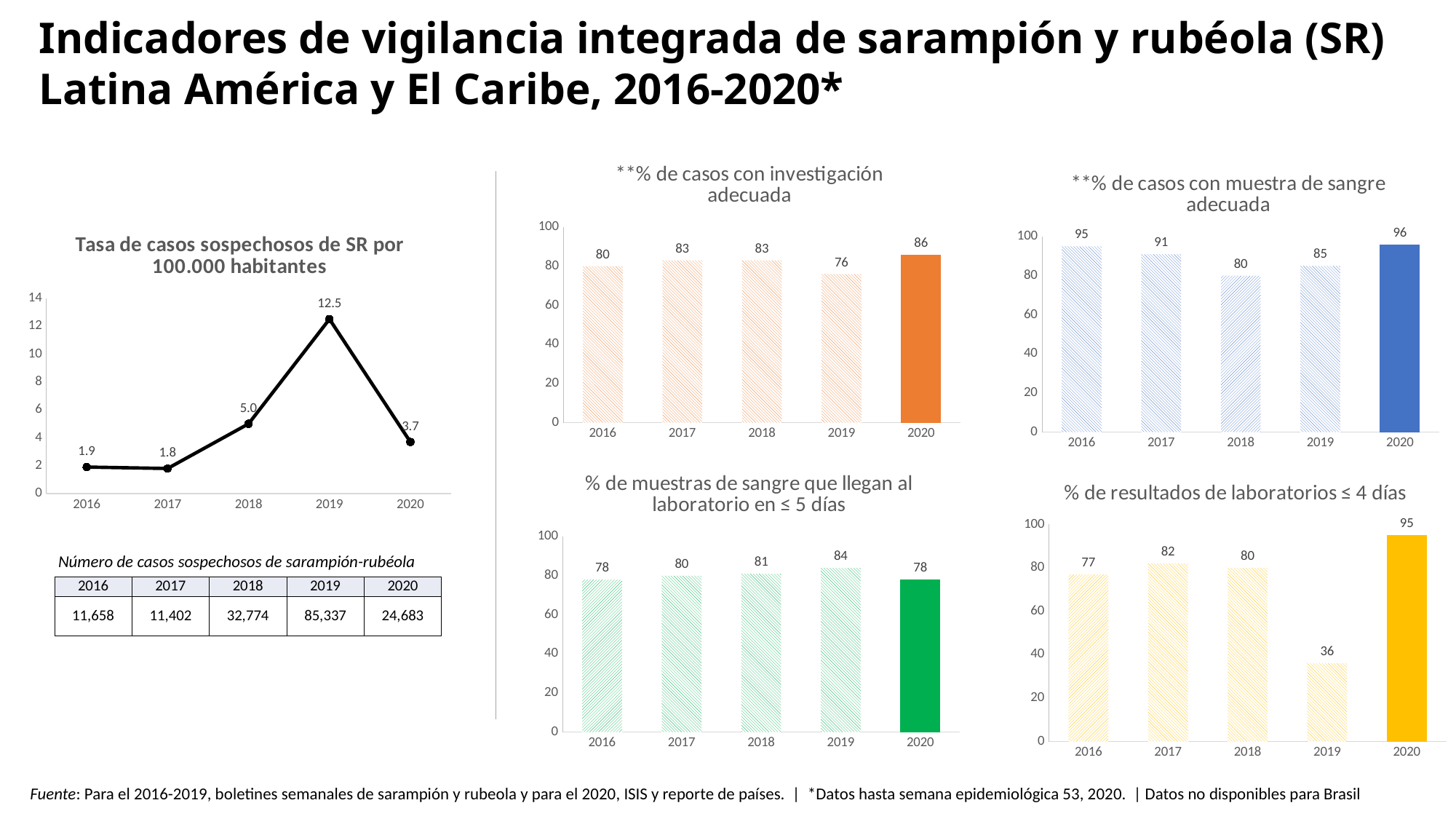
In the chart '**% de casos con investigación adecuada', what is the value for 2019? 76 In the chart 'Tasa de casos sospechosos de SR por 100.000 habitantes', what is the value for 2019? 12.5 In the chart '**% de casos con muestra de sangre adecuada', which year has the highest value? 2020 In the chart '% de resultados de laboratorios ≤ 4 días', what is the value for 2019? 36 In the chart '**% de casos con muestra de sangre adecuada', what is the value for 2018? 80 In the chart '% de muestras de sangre que llegan al laboratorio en ≤ 5 días', which year has the highest value? 2019 What kind of chart is 'Tasa de casos sospechosos de SR por 100.000 habitantes'? line chart In the chart 'Tasa de casos sospechosos de SR por 100.000 habitantes', which year has the lowest value? 2017 What kind of chart is '% de resultados de laboratorios ≤ 4 días'? bar chart In the chart '% de resultados de laboratorios ≤ 4 días', is the value for 2020 larger or smaller than the value for 2017? larger In the chart '% de muestras de sangre que llegan al laboratorio en ≤ 5 días', how many years are shown on the x axis? 5 In the chart '**% de casos con investigación adecuada', what is the difference between the 2020 and 2019 values? 10